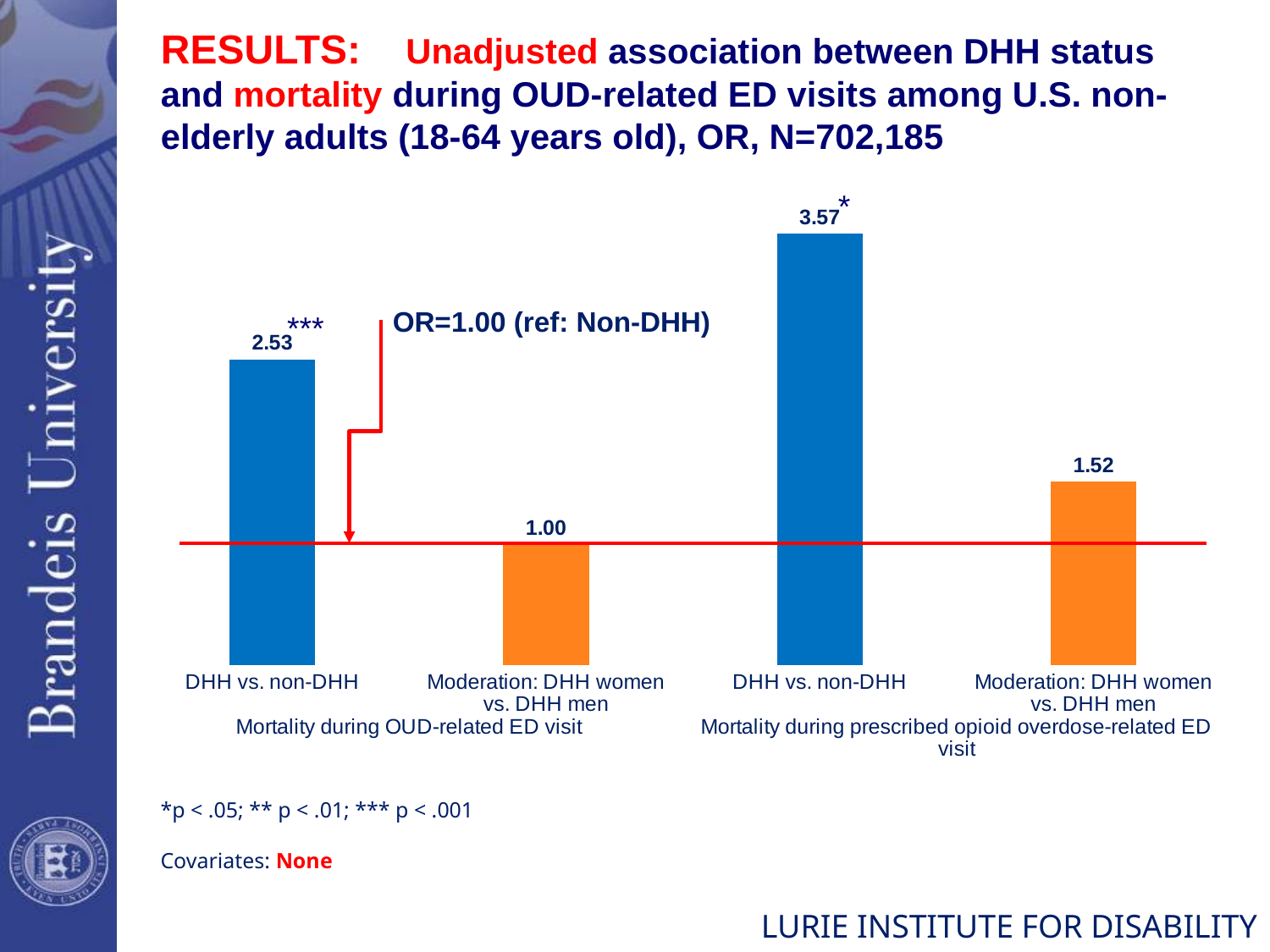
Which bar has the highest value on the chart? DHH vs. non-DHH, mortality during prescribed opioid overdose-related ED visit What colour are the DHH vs. non-DHH bars on the chart? Blue What is the difference between the DHH vs. non-DHH odds ratios for prescribed opioid overdose-related ED visit mortality and OUD-related ED visit mortality? 1.04 Which bar has the lowest value on the chart? Moderation: DHH women vs. DHH men, mortality during OUD-related ED visit What is the odds ratio for DHH vs. non-DHH for mortality during OUD-related ED visit? 2.53 What is the value for Moderation: DHH women vs. DHH men for mortality during OUD-related ED visit? 1.00 What reference odds ratio does the red horizontal line on the chart represent? OR=1.00 (ref: Non-DHH) How many bars are plotted on the chart? 4 Which is larger: the DHH vs. non-DHH odds ratio for OUD-related ED visit mortality or the moderation value for prescribed opioid overdose-related ED visit mortality? DHH vs. non-DHH for OUD-related ED visit mortality What is the odds ratio for DHH vs. non-DHH for mortality during prescribed opioid overdose-related ED visit? 3.57 What kind of chart is shown on the slide? Bar chart What is the value for Moderation: DHH women vs. DHH men for mortality during prescribed opioid overdose-related ED visit? 1.52